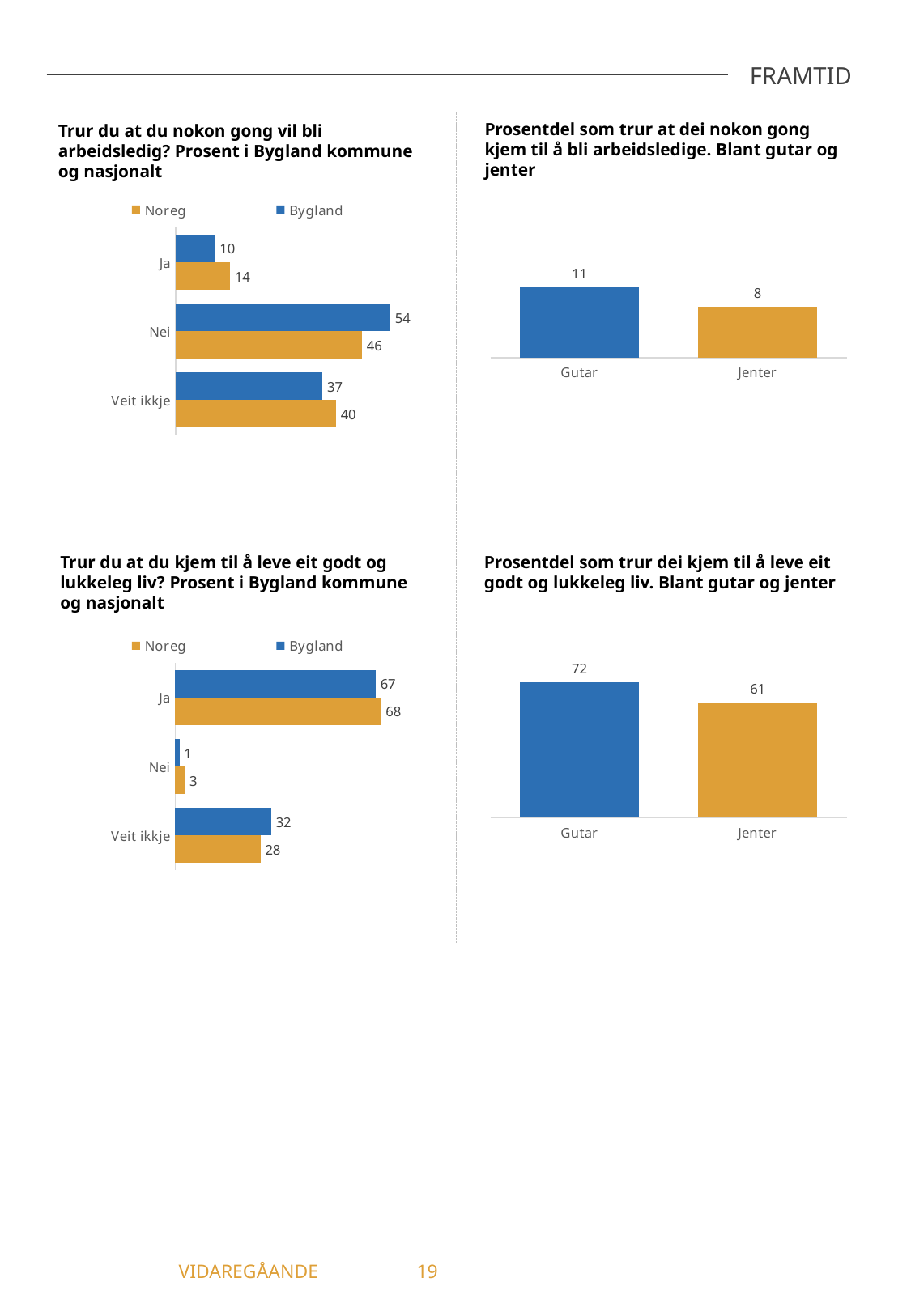
In the bottom-left chart (Trur du at du kjem til å leve eit godt og lukkeleg liv?), what is the value for Noreg in the Ja category? 68 In the top-left chart (Trur du at du nokon gong vil bli arbeidsledig?), what is the value for Bygland in the Nei category? 54 In the top-right chart (Prosentdel som trur at dei nokon gong kjem til å bli arbeidsledige), what is the value for Jenter? 8 What type of chart is the bottom-right chart (Prosentdel som trur dei kjem til å leve eit godt og lukkeleg liv)? Bar chart In the top-right chart (Prosentdel som trur at dei nokon gong kjem til å bli arbeidsledige), which category has the higher value, Gutar or Jenter? Gutar In the bottom-right chart (Prosentdel som trur dei kjem til å leve eit godt og lukkeleg liv), what is the value for Gutar? 72 In the bottom-left chart (Trur du at du kjem til å leve eit godt og lukkeleg liv?), how many categories are shown? 3 In the bottom-right chart (Prosentdel som trur dei kjem til å leve eit godt og lukkeleg liv), what is the difference between the values for Gutar and Jenter? 11 In the top-left chart (Trur du at du nokon gong vil bli arbeidsledig?), what is the difference between the Bygland and Noreg values for Nei? 8 In the top-left chart (Trur du at du nokon gong vil bli arbeidsledig?), how many series does the legend list? 2 In the bottom-left chart (Trur du at du kjem til å leve eit godt og lukkeleg liv?), which category has the lowest value for Bygland? Nei In the top-left chart (Trur du at du nokon gong vil bli arbeidsledig?), what is the value for Noreg in the Veit ikkje category? 40